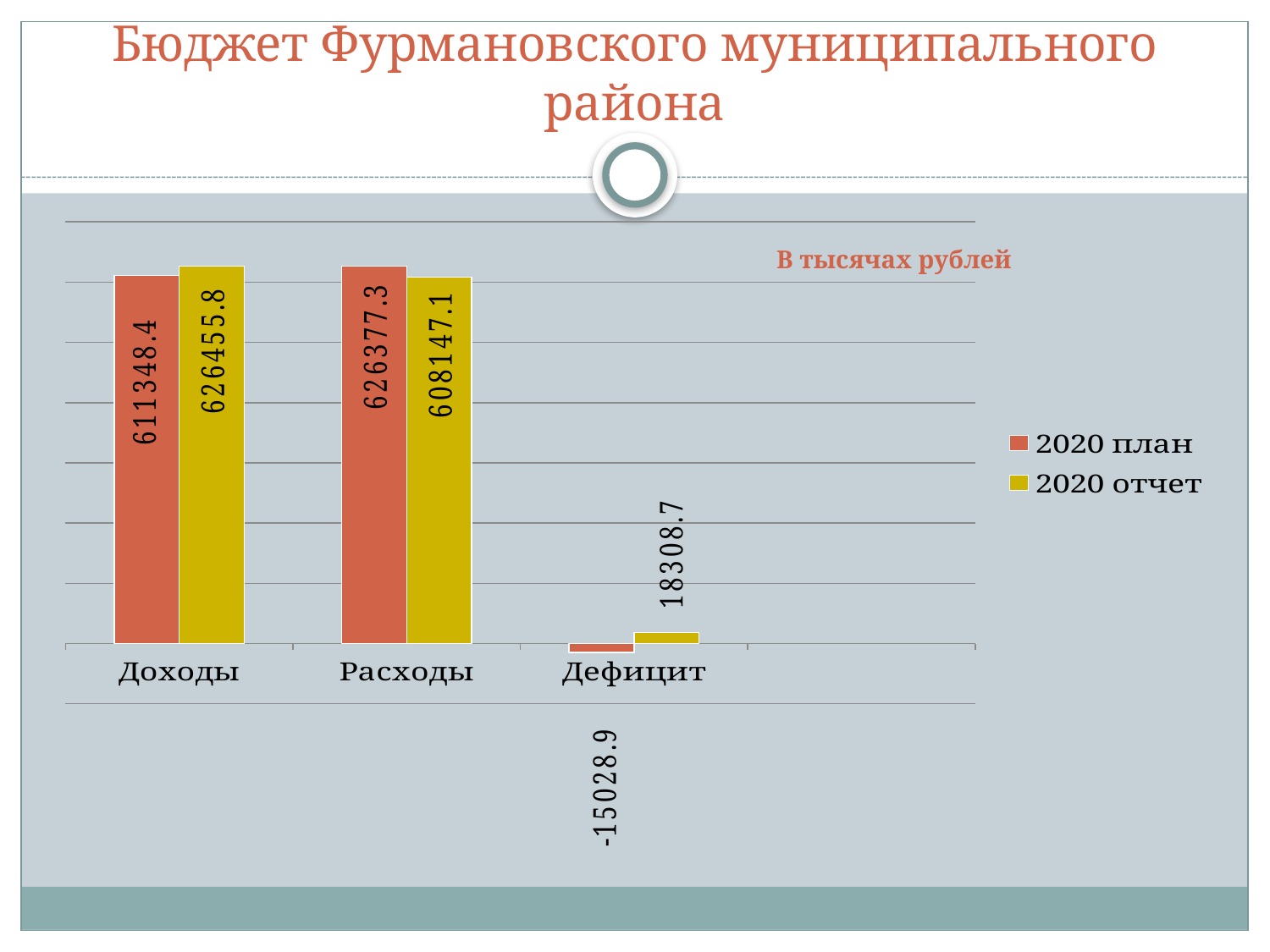
What is the value for Дефицит in the 2020 отчет series? 18308.7 How many series does the legend list? 2 How many categories are shown on the x axis? 3 For Доходы, which is larger: the 2020 план value or the 2020 отчет value? 2020 отчет What kind of chart is shown on the slide? Bar chart Which category has the highest value in the 2020 отчет series? Доходы What is the difference between the 2020 отчет and 2020 план values for Расходы? 18230.2 What is the value for Доходы in the 2020 план series? 611348.4 What is the value for Расходы in the 2020 план series? 626377.3 What is the value for Дефицит in the 2020 план series? -15028.9 Which category has the lowest value in the 2020 план series? Дефицит What is the value for Доходы in the 2020 отчет series? 626455.8